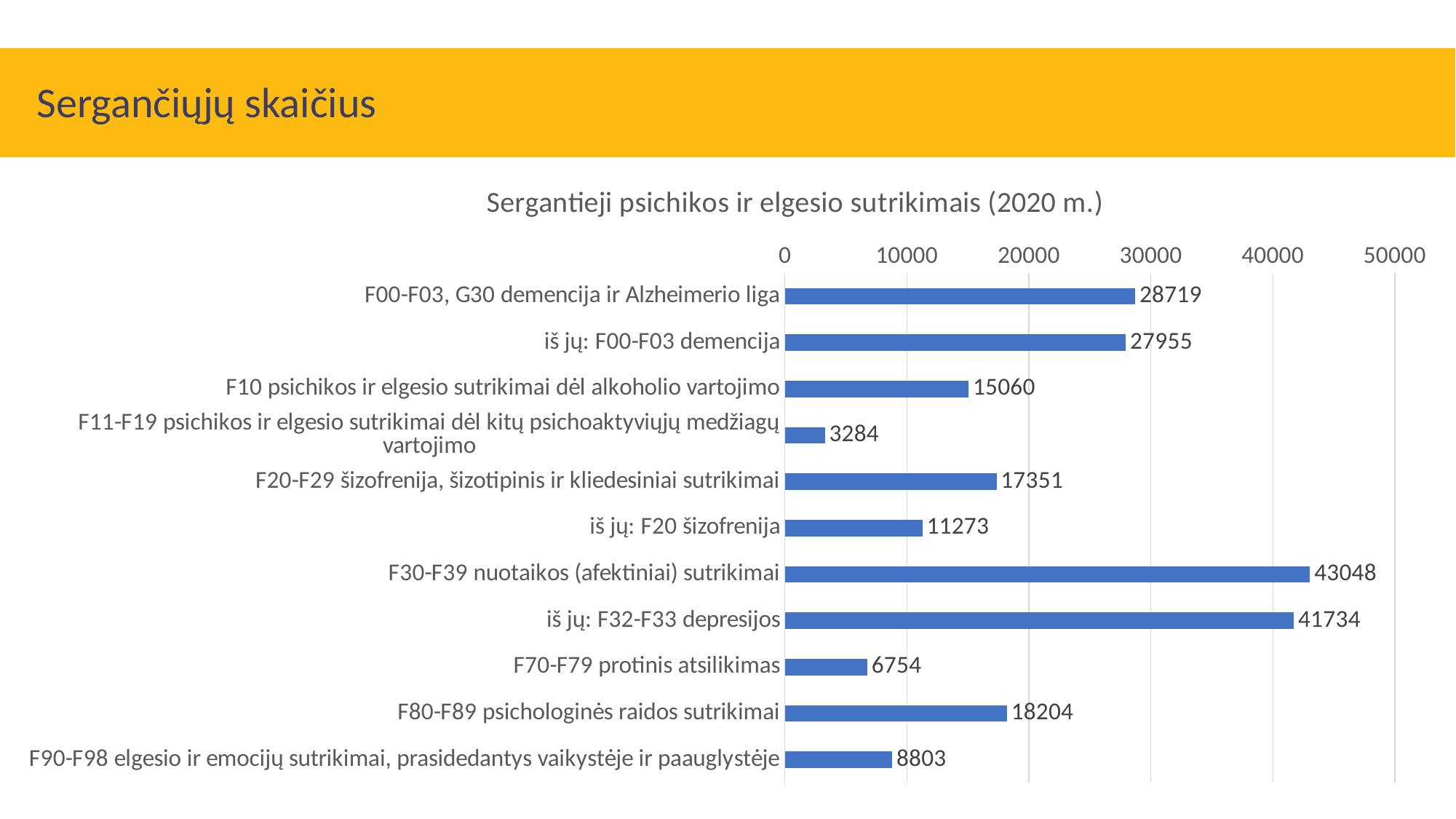
Is the value for F70-F79 protinis atsilikimas greater or less than 10000? less What kind of chart is shown on the slide? bar chart What is the difference between F30-F39 nuotaikos (afektiniai) sutrikimai and iš jų: F32-F33 depresijos? 1314 What is the value for F10 psichikos ir elgesio sutrikimai dėl alkoholio vartojimo? 15060 How many categories are shown in the chart? 11 What is the value for F30-F39 nuotaikos (afektiniai) sutrikimai? 43048 What is the value for iš jų: F20 šizofrenija? 11273 Which category has the lowest value? F11-F19 psichikos ir elgesio sutrikimai dėl kitų psichoaktyviųjų medžiagų vartojimo What is the title of the chart? Sergantieji psichikos ir elgesio sutrikimais (2020 m.) Which is larger: F80-F89 psichologinės raidos sutrikimai or F20-F29 šizofrenija, šizotipinis ir kliedesiniai sutrikimai? F80-F89 psichologinės raidos sutrikimai What is the difference between F00-F03, G30 demencija ir Alzheimerio liga and iš jų: F00-F03 demencija? 764 Which category has the highest value? F30-F39 nuotaikos (afektiniai) sutrikimai